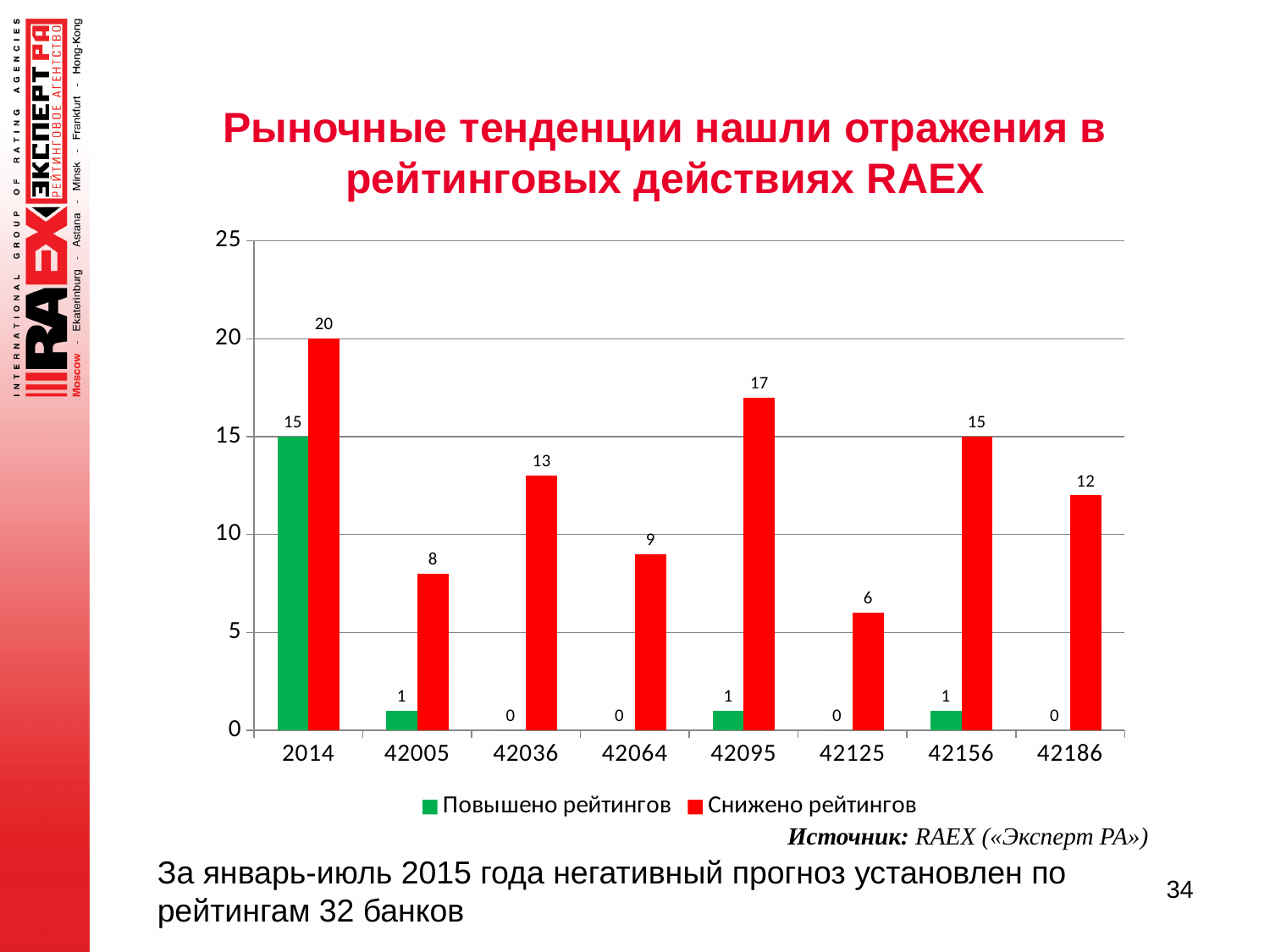
How many series does the legend list? 2 Which is larger: "Снижено рейтингов" for 42036 or for 42186? 42036 What is the value of "Повышено рейтингов" for 42036? 0 Which category has the lowest value for "Снижено рейтингов"? 42125 What colour are the bars for "Снижено рейтингов"? Red What is the value of "Повышено рейтингов" for 2014? 15 What is the value of "Снижено рейтингов" for 2014? 20 What is the difference between "Снижено рейтингов" and "Повышено рейтингов" for 2014? 5 What is the value of "Снижено рейтингов" for 42095? 17 What kind of chart is shown on the slide? Bar chart How many categories are shown on the x axis? 8 Which category has the highest value for "Снижено рейтингов"? 2014